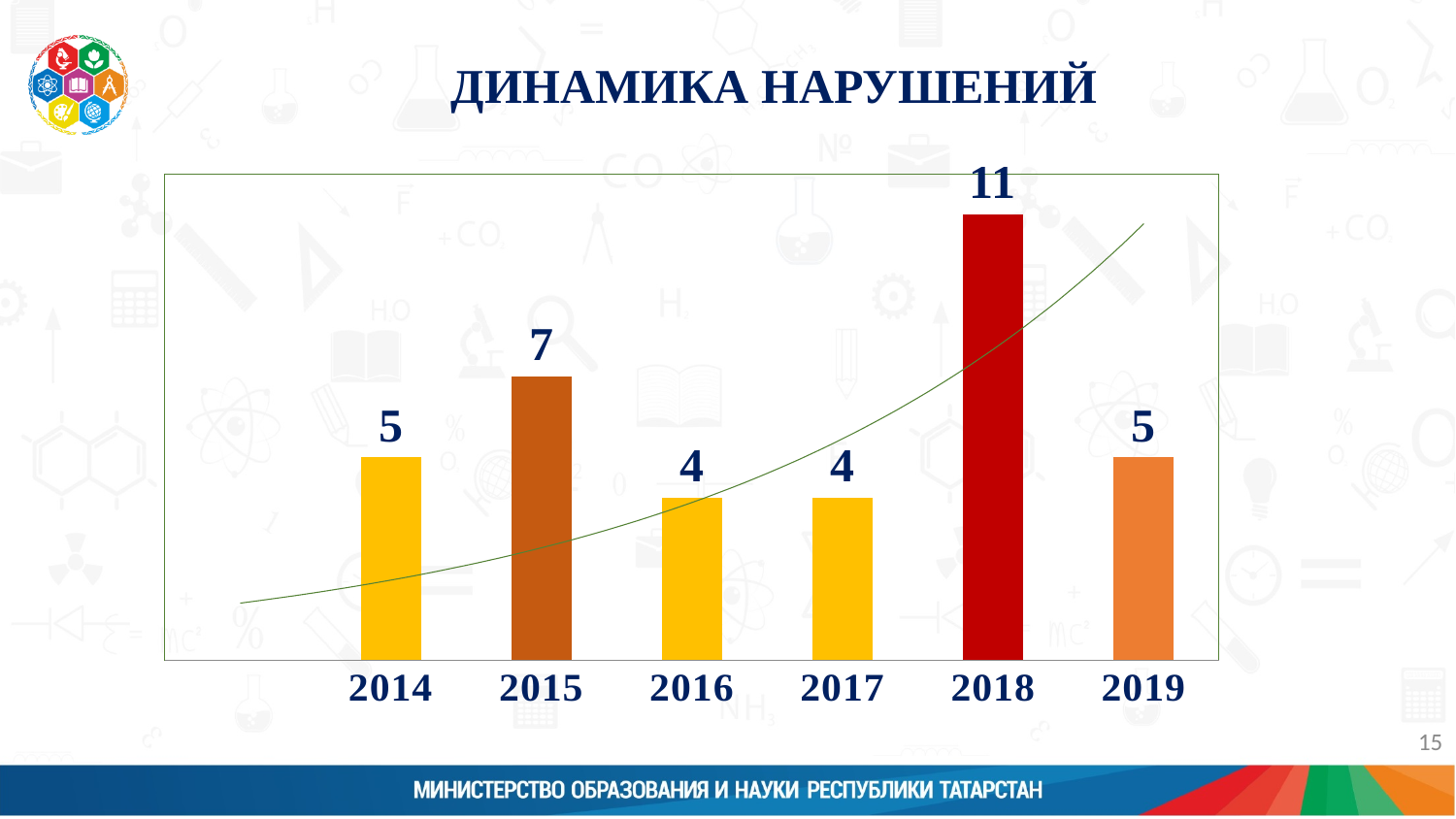
What is the value for 2018? 11 What kind of chart is shown on the slide? bar chart What is the title of the chart? ДИНАМИКА НАРУШЕНИЙ Do the values rise or fall from 2017 to 2018? rise What colour is the bar for 2018? dark red How many years are shown on the x axis? 6 What is the value for 2019? 5 Which year has the highest value? 2018 What is the difference between the values for 2018 and 2017? 7 What is the difference between the values for 2015 and 2014? 2 What is the value for 2015? 7 Which is larger, the value for 2015 or the value for 2019? 2015